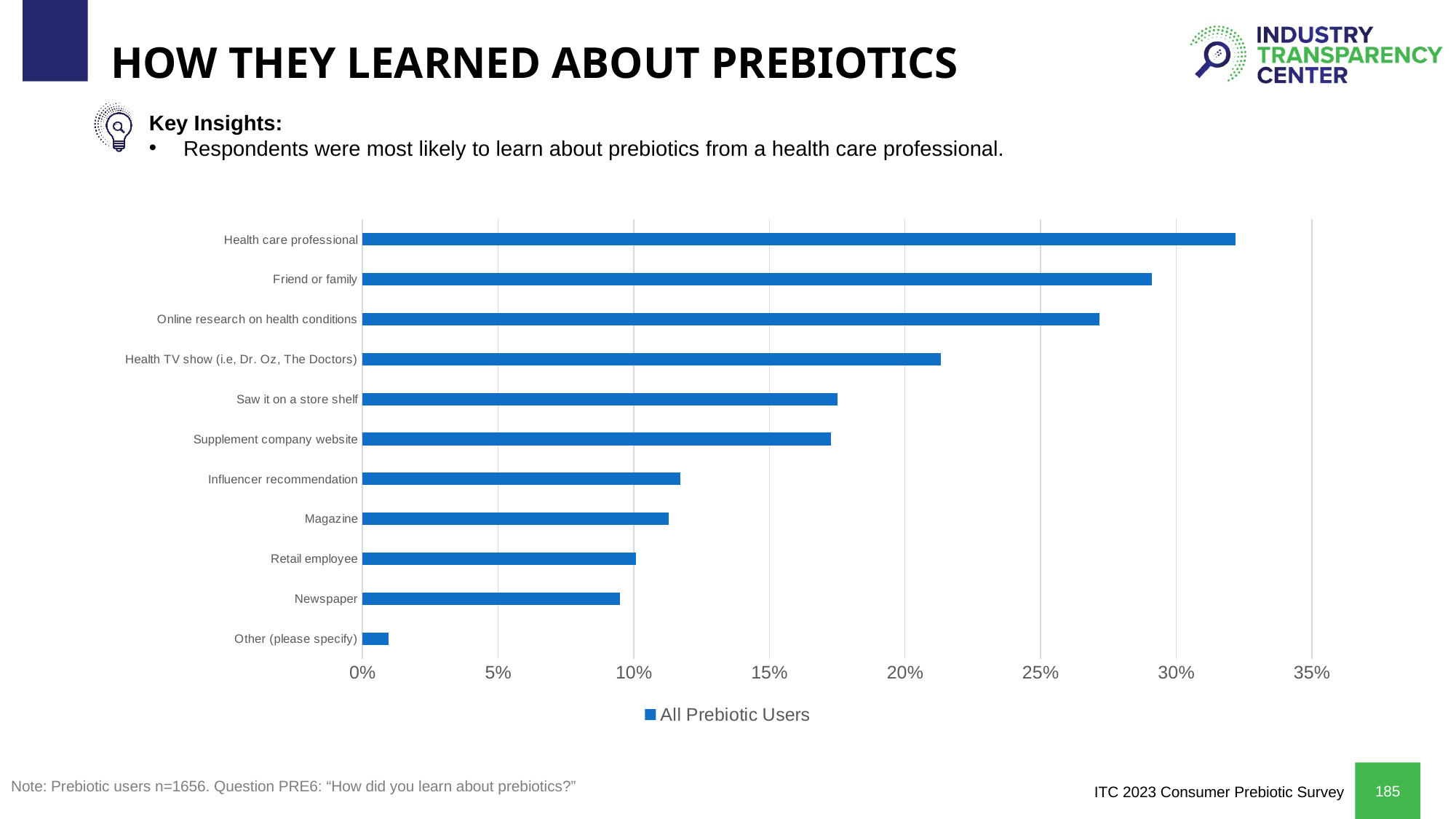
Is the value for Health care professional greater or less than 30%? greater How many categories are shown in the chart? 11 Which is larger, the value for Friend or family or the value for Health TV show (i.e, Dr. Oz, The Doctors)? Friend or family Is the value for Saw it on a store shelf greater or less than 20%? less What kind of chart is shown on the slide? Bar chart Is the value for Other (please specify) greater or less than 5%? less Which category has the highest value in the chart? Health care professional Which category has the lowest value in the chart? Other (please specify)